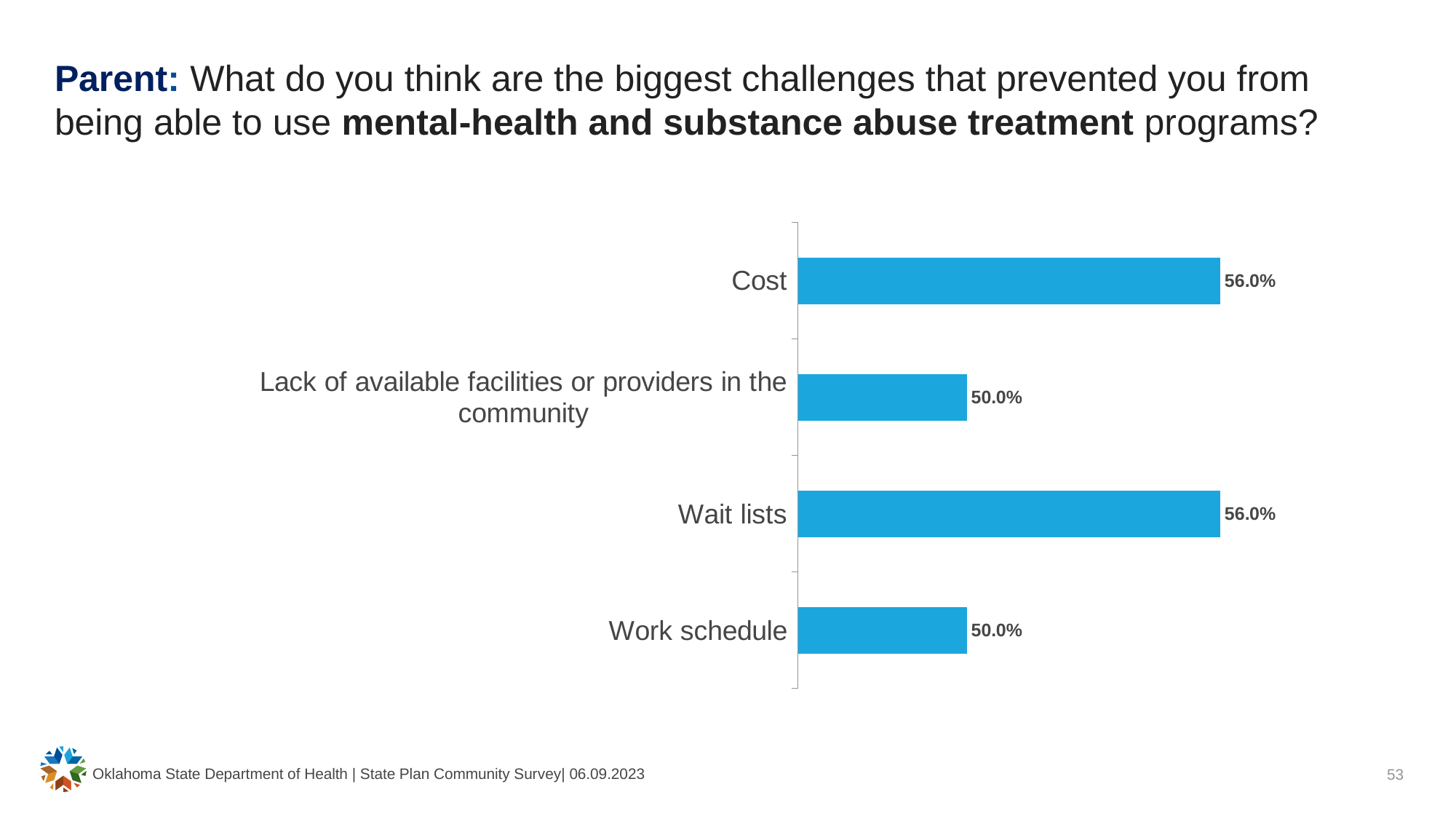
What is the value for Work schedule? 50.0% What is the value for Lack of available facilities or providers in the community? 50.0% What kind of chart is shown on the slide? Bar chart What is the value for Cost? 56.0% Are the values for Cost and Wait lists equal? Yes Which categories share the highest value? Cost and Wait lists What colour are the bars in the chart? Blue What is the value for Wait lists? 56.0% What is the difference between the values for Cost and Work schedule? 6.0% How many categories are shown in the chart? 4 Which categories share the lowest value? Lack of available facilities or providers in the community and Work schedule Which is larger, the value for Wait lists or the value for Lack of available facilities or providers in the community? Wait lists